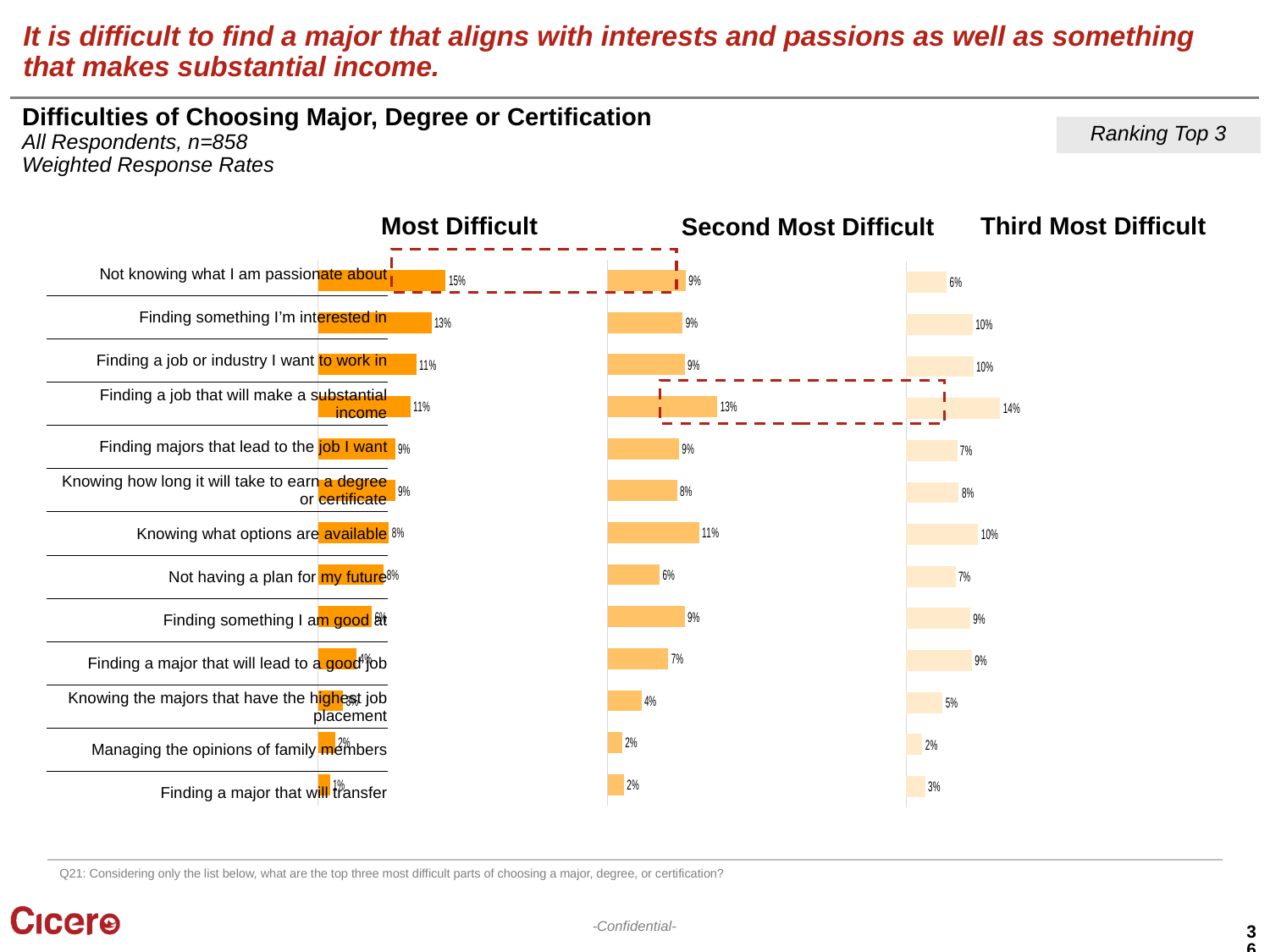
In the Most Difficult chart, what is the value for "Not knowing what I am passionate about"? 15% What is the sample size (n) stated in the chart subtitle? n=858 In the Most Difficult chart, which category has the highest value? Not knowing what I am passionate about In the Second Most Difficult chart, what is the difference between "Finding a job that will make a substantial income" and "Not having a plan for my future"? 7% In the Most Difficult chart, what is the difference between "Not knowing what I am passionate about" and "Finding something I'm interested in"? 2% In the Third Most Difficult chart, which is larger: "Finding something I'm interested in" or "Not knowing what I am passionate about"? Finding something I'm interested in What kind of chart is the Second Most Difficult chart? Bar chart In the Second Most Difficult chart, what is the value for "Finding a job that will make a substantial income"? 13% How many categories are listed in the Most Difficult chart? 13 In the Most Difficult chart, which category has the lowest value? Finding a major that will transfer In the Third Most Difficult chart, what is the value for "Knowing what options are available"? 10% In the Third Most Difficult chart, which category has the highest value? Finding a job that will make a substantial income